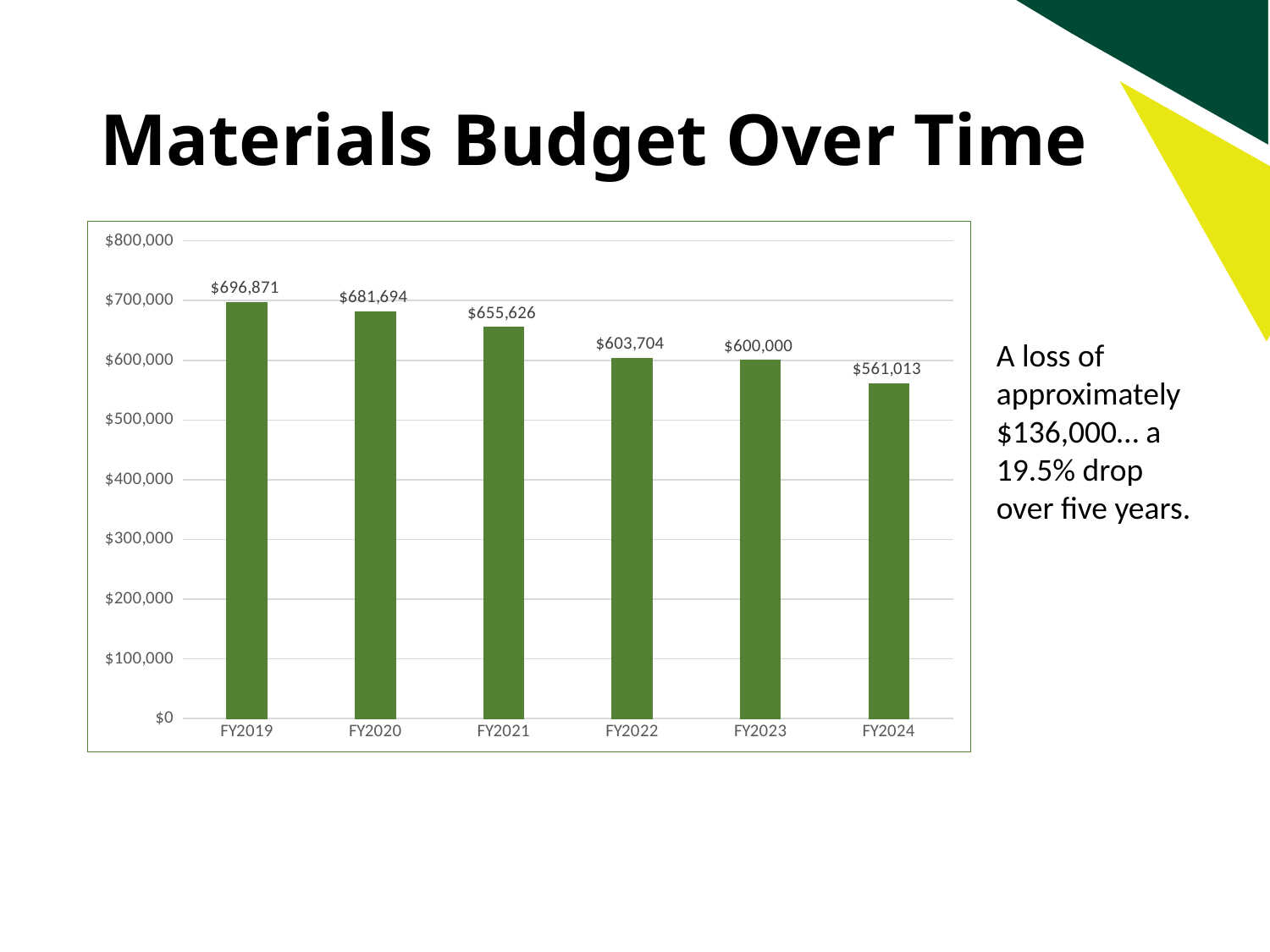
Which fiscal year has the highest materials budget? FY2019 How many fiscal years are shown on the chart? 6 Which is larger, the materials budget for FY2020 or for FY2023? FY2020 What is the materials budget for FY2022? $603,704 What is the materials budget for FY2024? $561,013 What is the materials budget for FY2021? $655,626 What kind of chart is shown on the slide? bar chart What is the difference between the FY2020 and FY2021 materials budgets? $26,068 Is the materials budget for FY2024 greater or less than $600,000? less Which fiscal year has the lowest materials budget? FY2024 What is the difference between the FY2019 and FY2024 materials budgets? $135,858 What is the materials budget for FY2019? $696,871